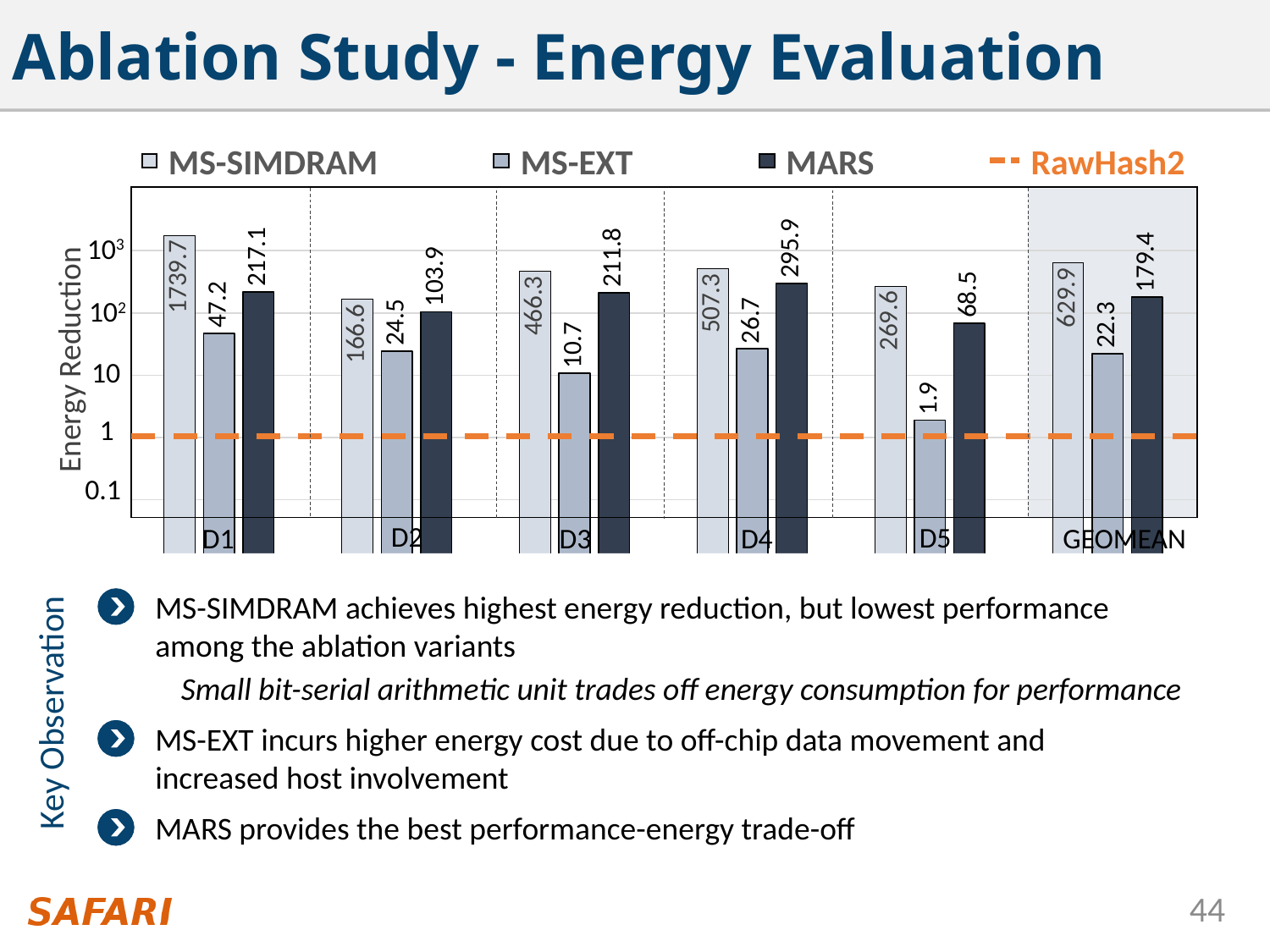
Is the MS-EXT value for D5 greater or less than 10? less What is the GEOMEAN energy reduction value for MARS? 179.4 How many categories are shown on the x axis? 6 What is the energy reduction value for MS-EXT on D5? 1.9 What is the difference between the MARS and MS-EXT energy reduction values on D3? 201.1 What is the energy reduction value for MARS on D4? 295.9 Which is larger on D2: the MS-SIMDRAM value or the MARS value? MS-SIMDRAM How many entries does the legend list? 4 What type of chart is shown on the slide? bar chart What is the energy reduction value for MS-SIMDRAM on D1? 1739.7 Which dataset has the highest MS-SIMDRAM energy reduction? D1 Which dataset has the lowest MS-EXT energy reduction? D5